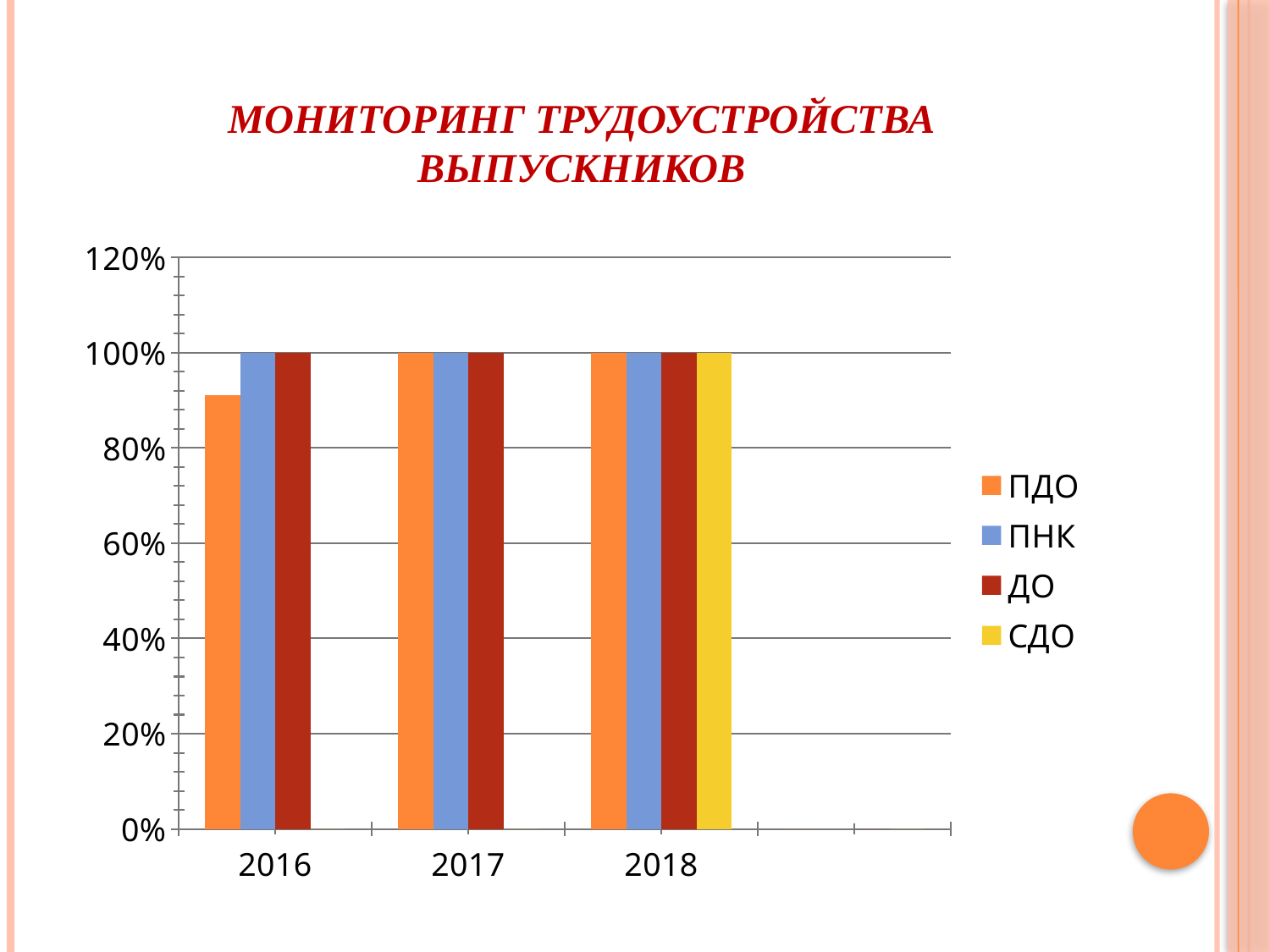
What kind of chart is shown on the slide? bar chart How many years are shown on the x axis? 3 What is the value for ДО in 2017? 100% Is the value for ПДО in 2016 greater or less than 80%? greater Is the value for ПДО in 2016 greater or less than 100%? less What is the value for СДО in 2018? 100% How many series does the legend list? 4 Which series has the lowest value in 2016? ПДО How many bars are shown for 2018? 4 Does the value for ПДО rise or fall from 2016 to 2017? rise What is the value for ПНК in 2016? 100% In 2016, which is larger: the value for ПДО or the value for ПНК? ПНК